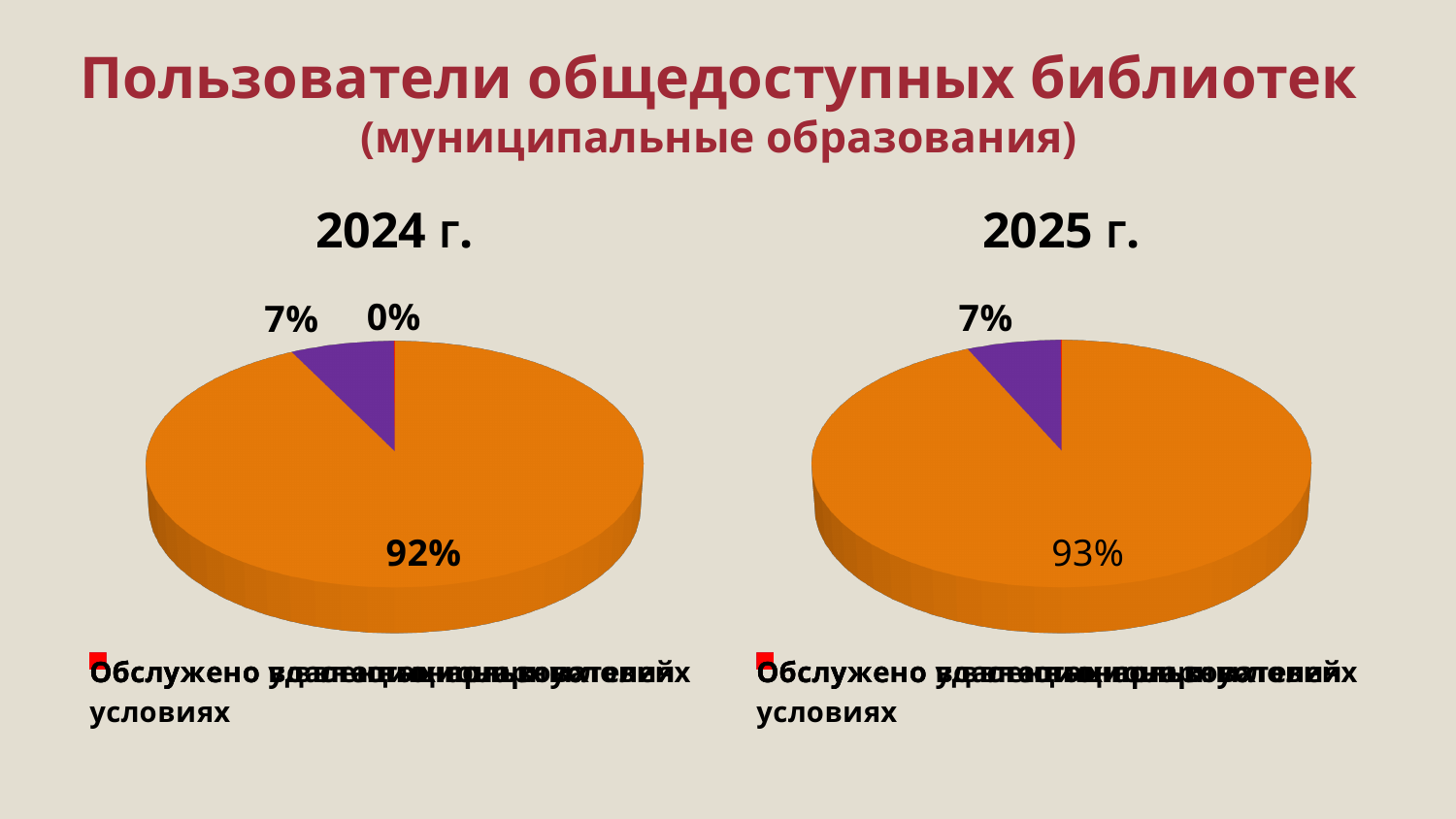
In the 2024 г. pie chart, what is the smallest percentage label shown? 0% In the 2025 г. pie chart, what percentage is shown for the purple slice? 7% How many percentage labels are shown on the 2024 г. pie chart? 3 Which chart has the larger orange slice, 2024 г. or 2025 г.? 2025 г. In the 2024 г. pie chart, what percentage is shown for the purple slice? 7% In the 2024 г. pie chart, what is the difference between the 92% slice and the 7% slice? 85 percentage points How many percentage labels are shown on the 2025 г. pie chart? 2 What is the difference between the orange slice in the 2025 г. chart (93%) and the orange slice in the 2024 г. chart (92%)? 1 percentage point In the 2025 г. pie chart, what percentage is shown for the largest (orange) slice? 93% In the 2024 г. pie chart, what percentage is shown for the largest (orange) slice? 92% What kind of chart is used on this slide for 2024 г. and 2025 г.? Pie chart How many pie charts are on the slide? 2